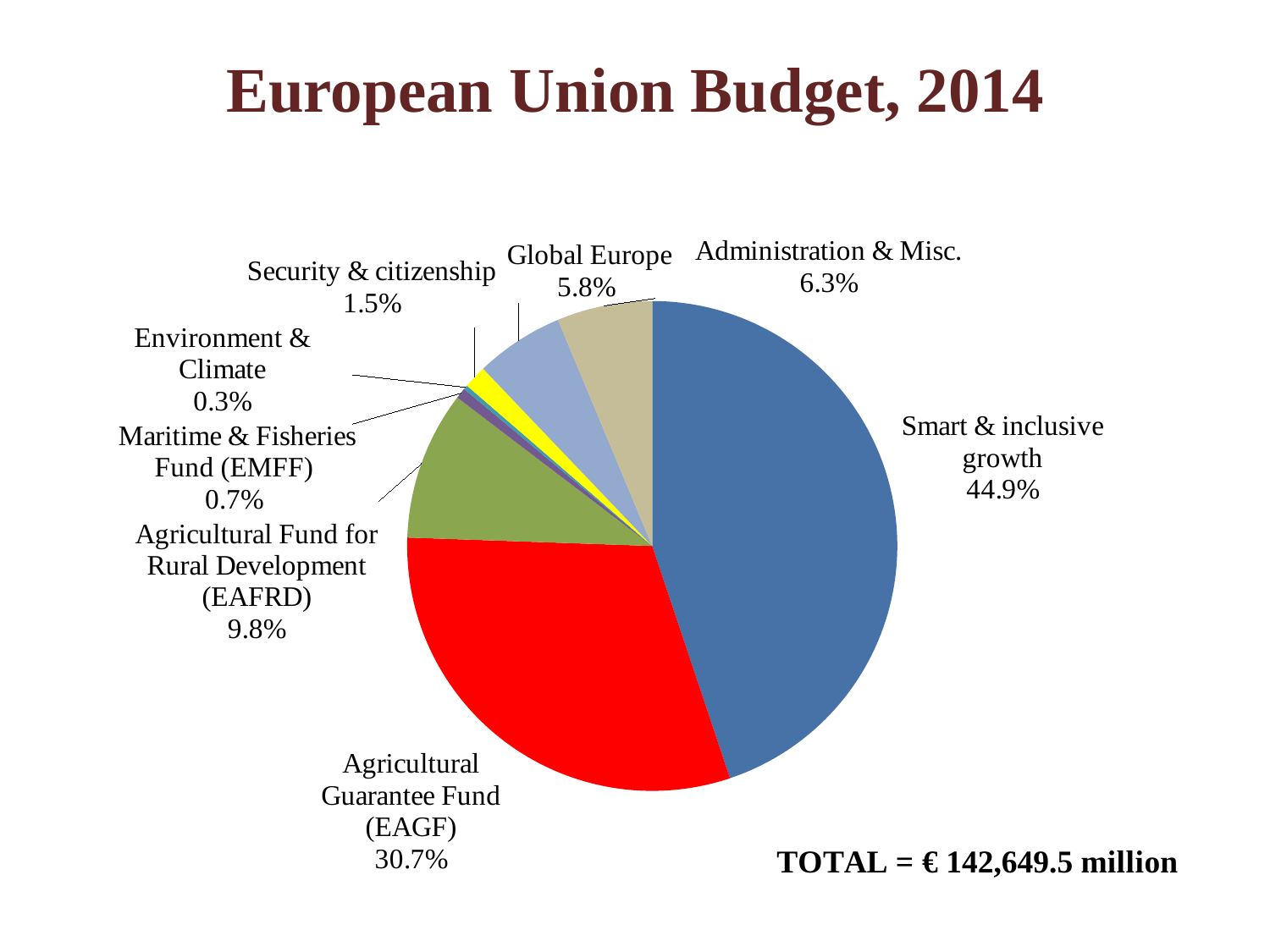
What share of the budget goes to Smart & inclusive growth? 44.9% What percentage is shown for Environment & Climate? 0.3% What percentage is shown for the Agricultural Guarantee Fund (EAGF)? 30.7% Which is larger, Administration & Misc. or Global Europe? Administration & Misc. Which category has the smallest slice of the pie? Environment & Climate What is the title of the chart? European Union Budget, 2014 Which category has the largest slice of the pie? Smart & inclusive growth How many categories are shown in the pie chart? 8 What type of chart is shown on the slide? pie chart What percentage is shown for Global Europe? 5.8% What is the difference in percentage points between Smart & inclusive growth and the Agricultural Guarantee Fund (EAGF)? 14.2 What total budget amount is stated on the slide? € 142,649.5 million